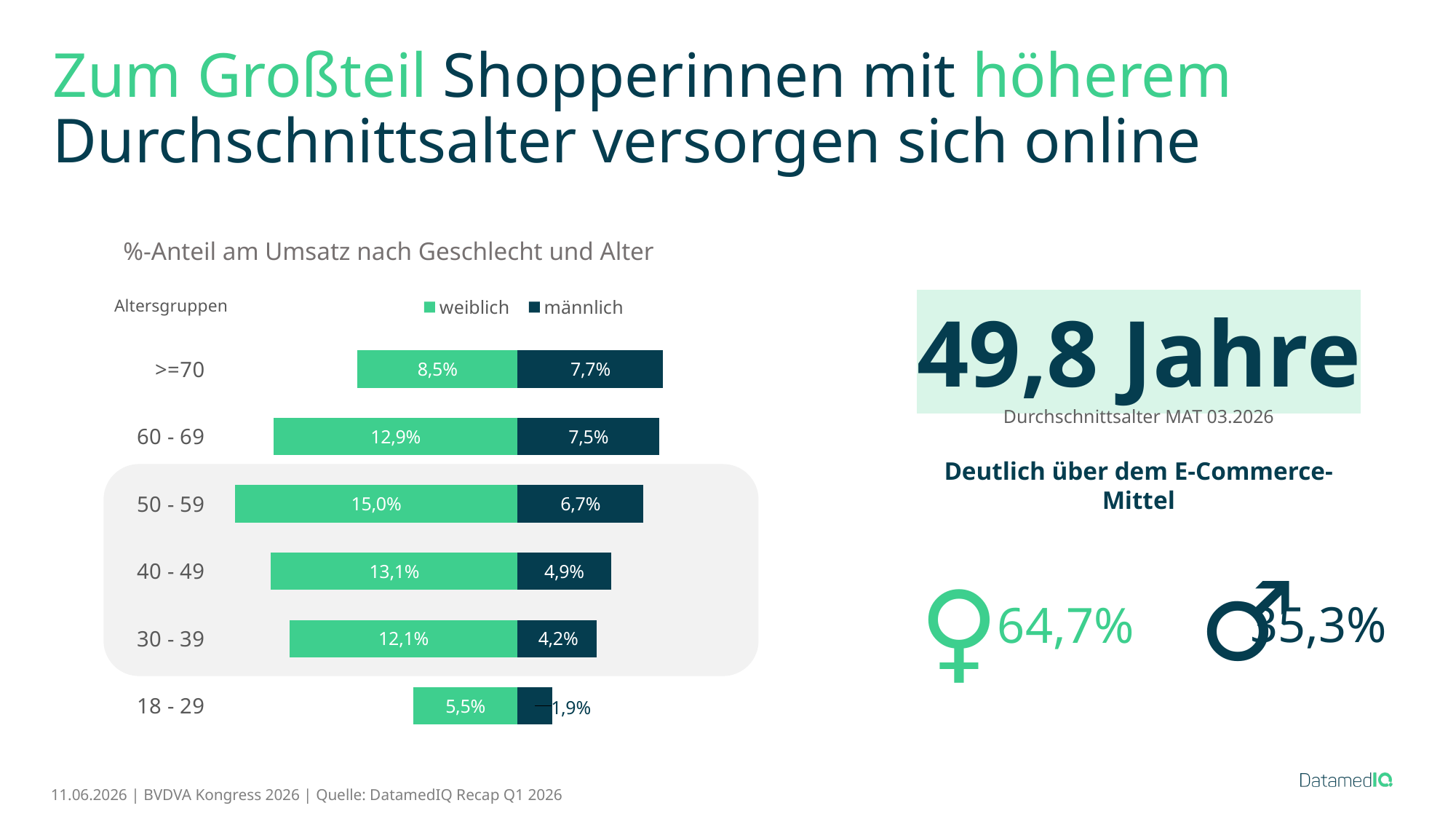
Which is larger: the weiblich value for 60 - 69 or the weiblich value for 30 - 39? 60 - 69 What is the männlich value for the >=70 age group? 7,7% How many age groups are shown in the chart? 6 What is the title of the chart? %-Anteil am Umsatz nach Geschlecht und Alter What is the männlich value for the 18 - 29 age group? 1,9% Which age group has the highest weiblich value? 50 - 59 What is the difference between the weiblich and männlich values for the 40 - 49 age group? 8,2% What kind of chart is shown on the slide? Bar chart What is the combined weiblich and männlich value for the >=70 age group? 16,2% How many series does the legend list? 2 What is the weiblich value for the 50 - 59 age group? 15,0% Which age group has the lowest männlich value? 18 - 29